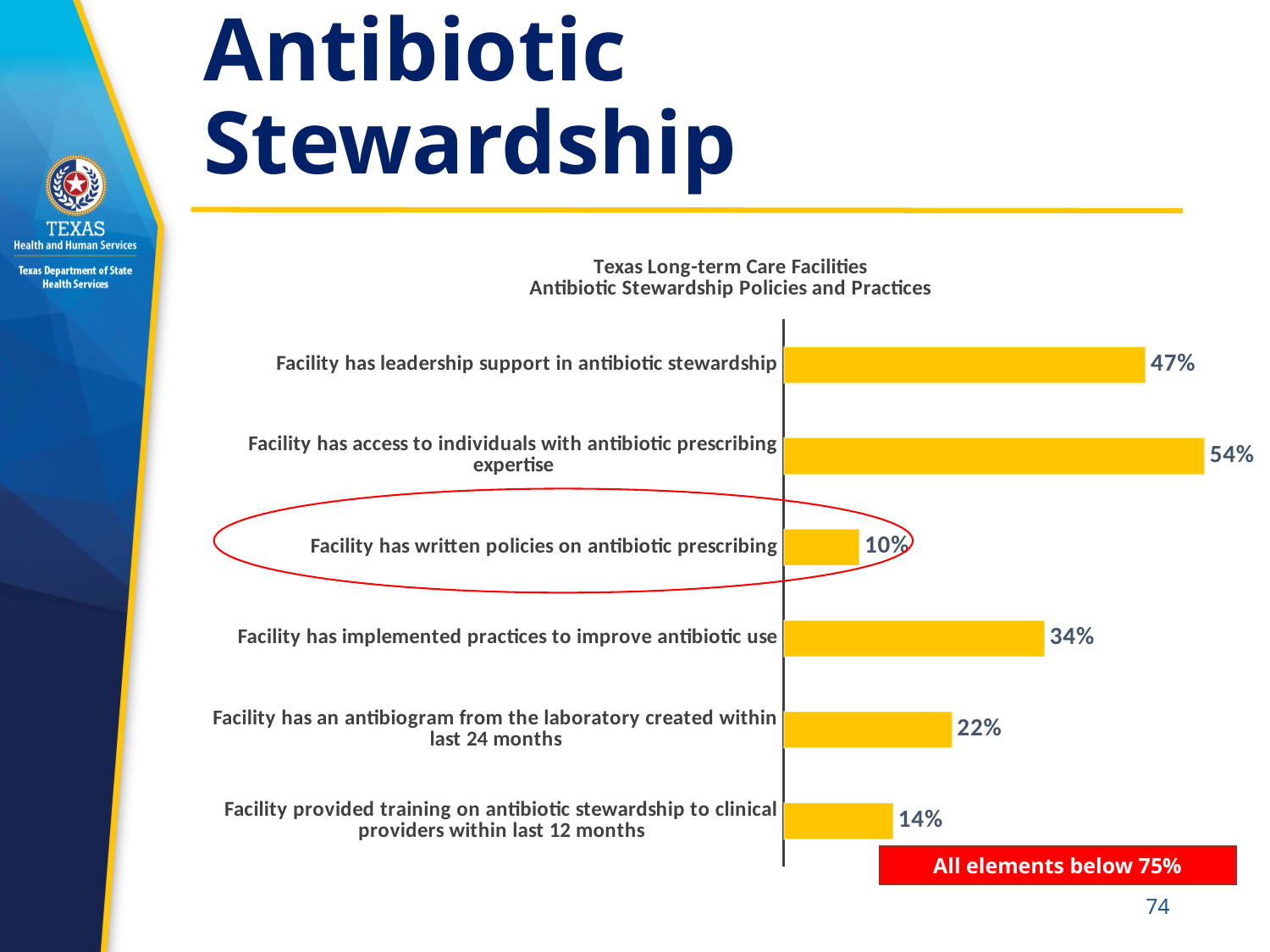
Which category has the lowest value in the chart? Facility has written policies on antibiotic prescribing What percentage of facilities provided training on antibiotic stewardship to clinical providers within the last 12 months? 14% Which is larger: the percentage of facilities that have implemented practices to improve antibiotic use, or the percentage with an antibiogram created within the last 24 months? Facility has implemented practices to improve antibiotic use What percentage of facilities have an antibiogram from the laboratory created within the last 24 months? 22% What does the red box at the bottom of the chart say? All elements below 75% What is the difference between the percentage of facilities with access to antibiotic prescribing expertise and the percentage with leadership support in antibiotic stewardship? 7% Which category has the highest value in the chart? Facility has access to individuals with antibiotic prescribing expertise What type of chart is shown on the slide? Bar chart How many categories are shown in the chart? 6 What percentage of facilities have leadership support in antibiotic stewardship? 47% What percentage of facilities have written policies on antibiotic prescribing? 10% What is the title of the chart? Texas Long-term Care Facilities Antibiotic Stewardship Policies and Practices